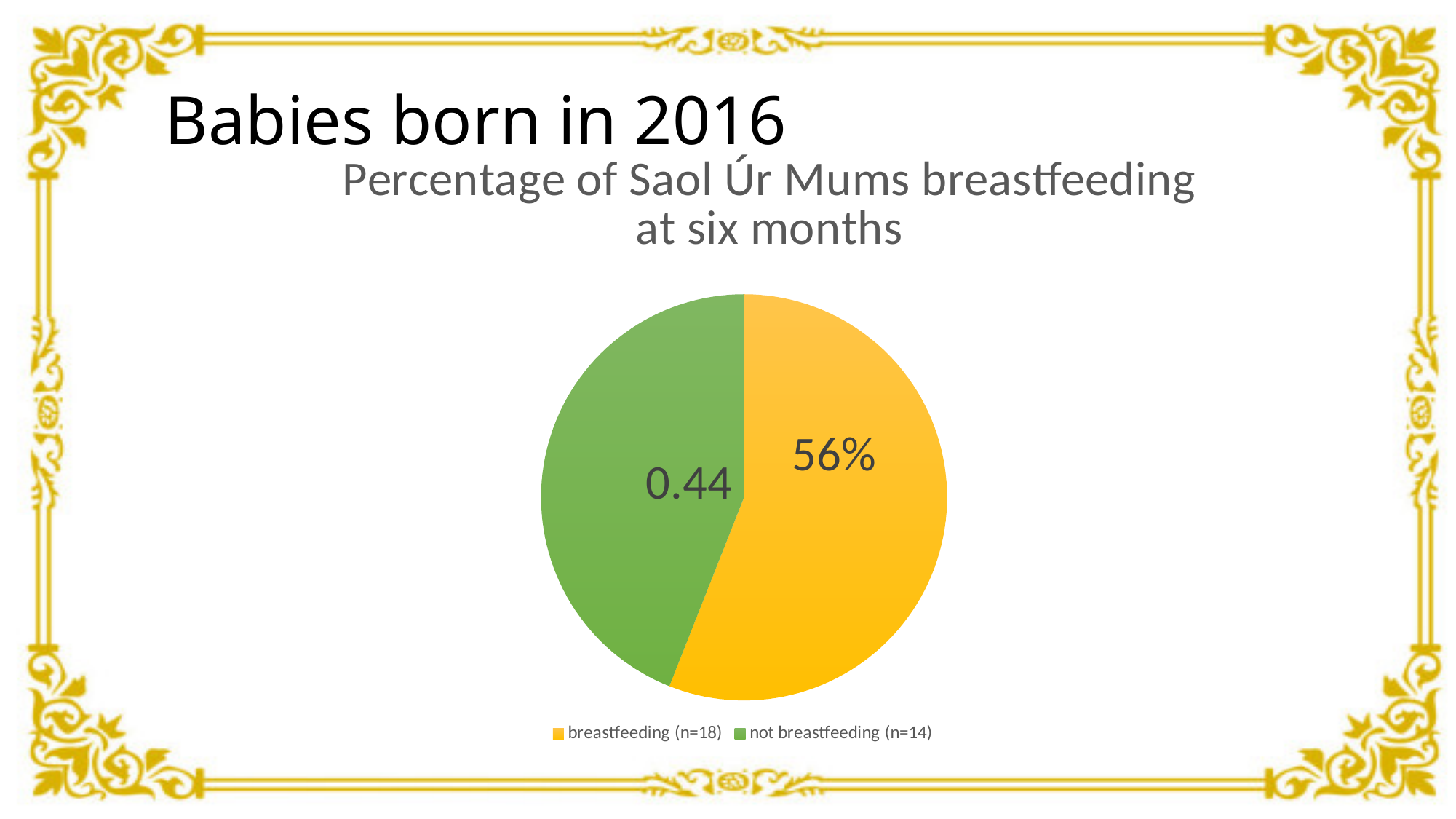
What colour is the breastfeeding (n=18) slice? orange What value is shown on the breastfeeding (n=18) slice? 56% How many slices does the pie chart have? 2 What value is shown on the not breastfeeding (n=14) slice? 0.44 What is the title of the chart? Percentage of Saol Úr Mums breastfeeding at six months What share of the pie does the breastfeeding (n=18) slice represent? 56% What type of chart is shown on the slide? pie chart Which slice is the smallest? not breastfeeding (n=14) Which is larger, the breastfeeding (n=18) slice or the not breastfeeding (n=14) slice? breastfeeding (n=18) How many entries does the legend list? 2 Which slice is the largest? breastfeeding (n=18)